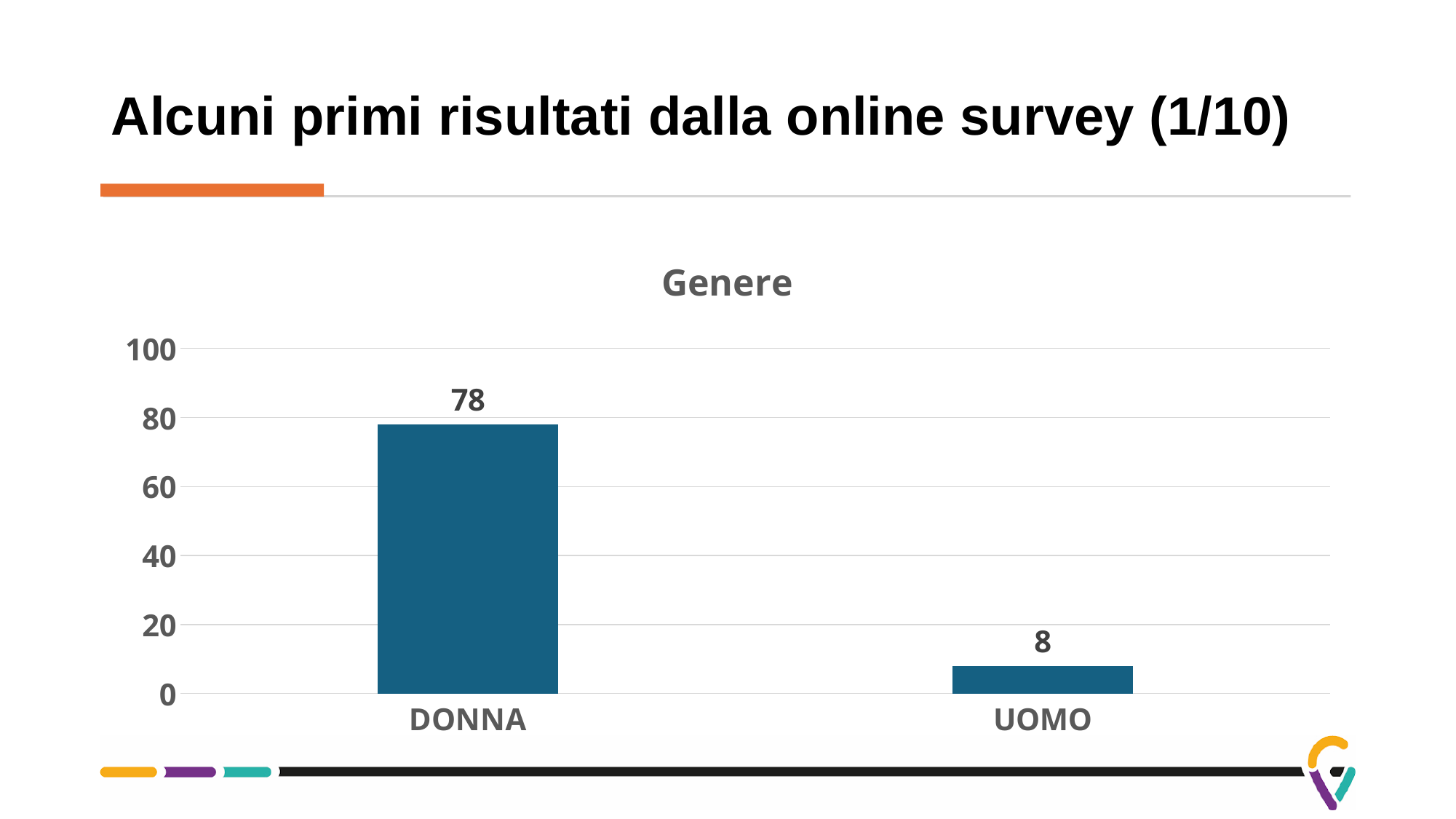
What kind of chart is shown on the slide? bar chart What is the title of the chart? Genere What is the value for DONNA? 78 Is the value for DONNA greater or less than 60? greater Which category has the highest value? DONNA What is the difference between the values for DONNA and UOMO? 70 Which category has the lowest value? UOMO How many categories are shown on the x axis? 2 What is the highest value shown on the y axis? 100 Which is larger, the value for DONNA or the value for UOMO? DONNA What is the value for UOMO? 8 Is the value for UOMO greater or less than 20? less